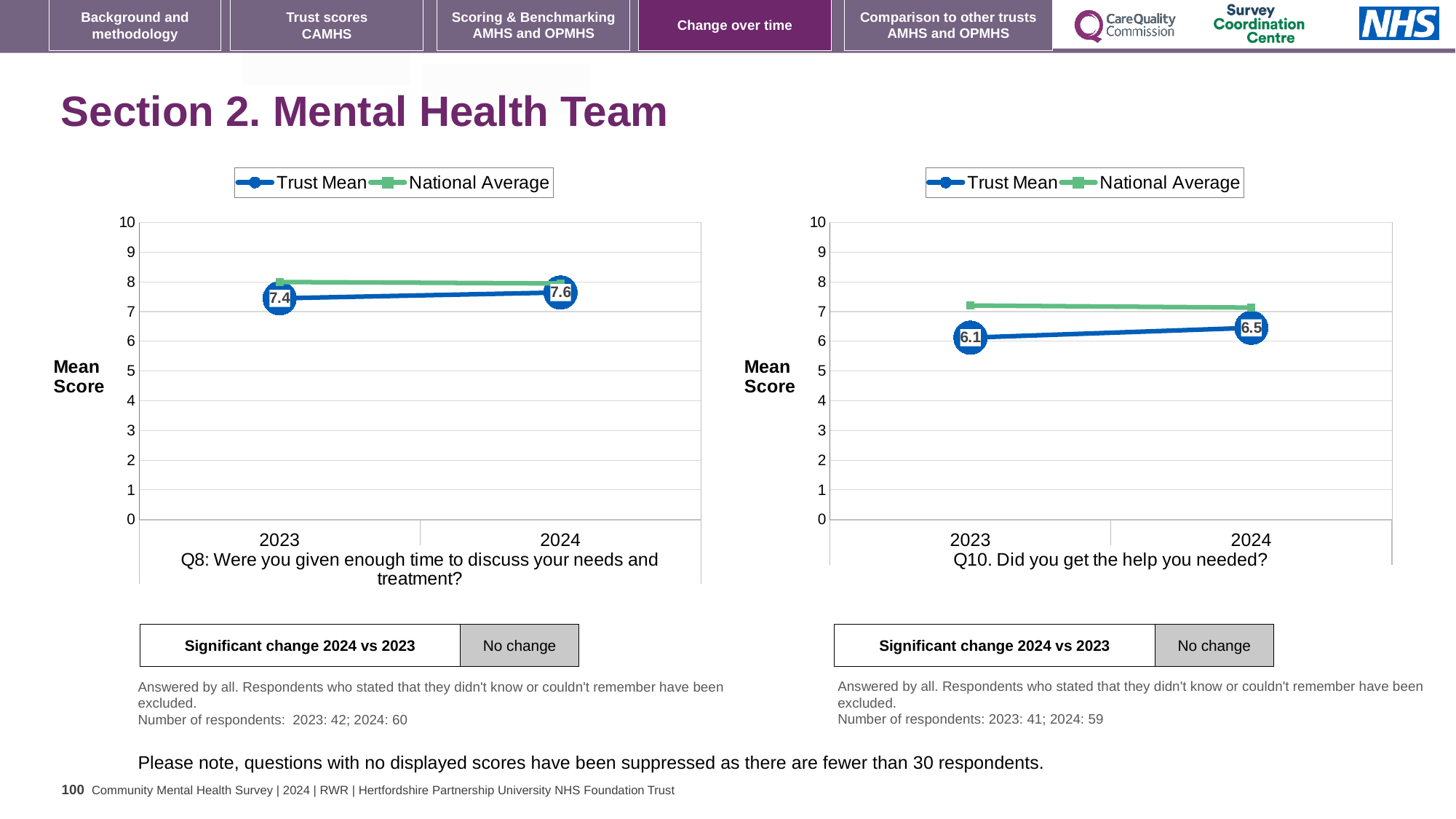
In the Q10 chart (right), by how much did the Trust Mean change from 2023 to 2024? 0.4 How many years are shown on the x axis of the Q8 chart (left)? 2 In the Q8 chart (left), what is the Trust Mean score for 2024? 7.6 In the Q10 chart (right), what is the Trust Mean score for 2023? 6.1 In the Q10 chart (right), is the National Average for 2023 greater or less than 8? less In the Q10 chart (right), does the Trust Mean rise or fall from 2023 to 2024? rise In the Q8 chart (left), what is the Trust Mean score for 2023? 7.4 In the Q8 chart (left), which is higher in 2023, the Trust Mean or the National Average? National Average In the Q8 chart (left), by how much did the Trust Mean change from 2023 to 2024? 0.2 In the Q10 chart (right), what is the Trust Mean score for 2024? 6.5 What type of chart is the Q8 chart (left)? line chart How many series does the legend of the Q10 chart (right) list? 2